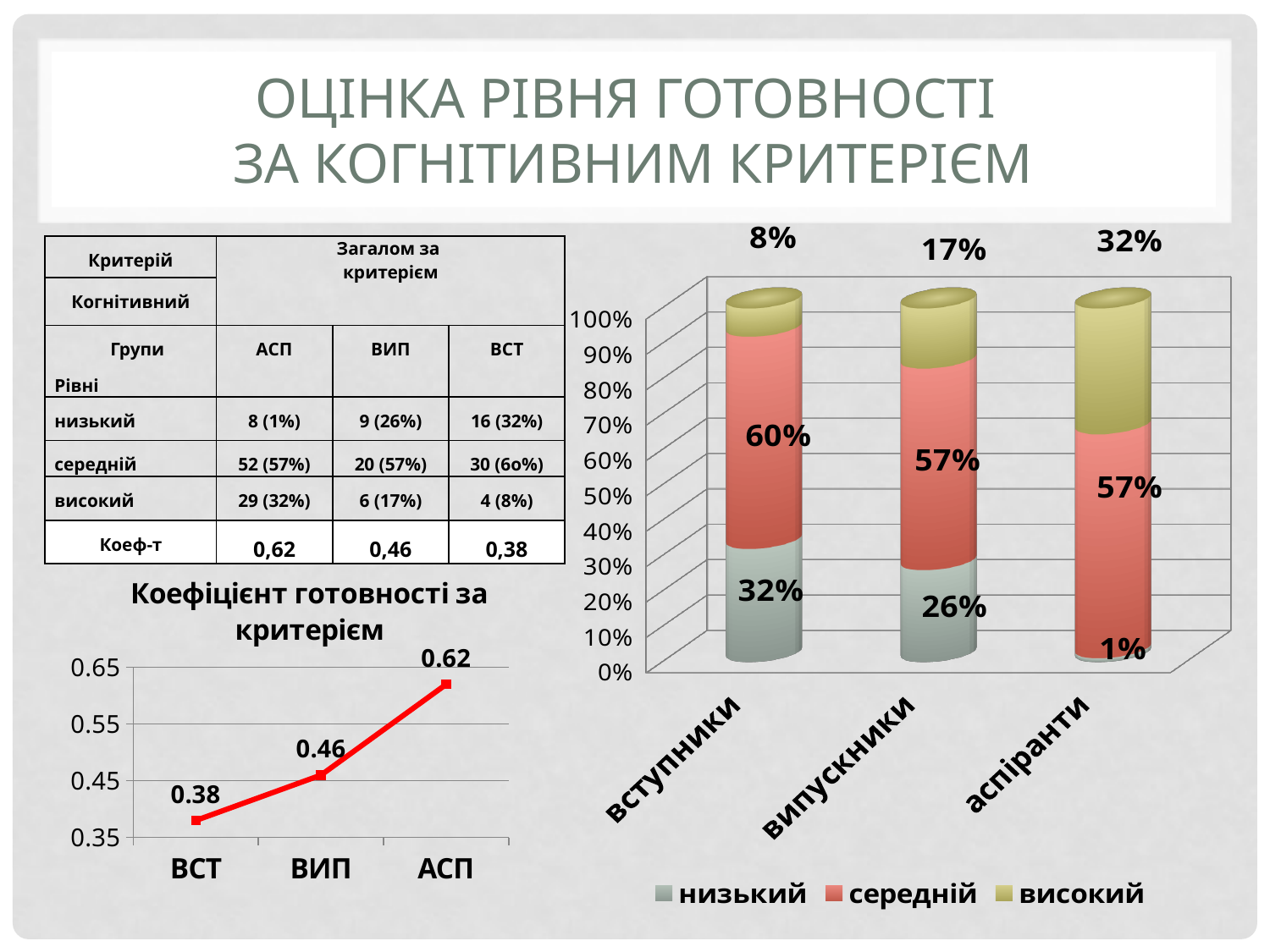
In the line chart titled 'Коефіцієнт готовності за критерієм', which category has the lowest value? ВСТ In the stacked bar chart on the right, what is the value of 'високий' for випускники? 17% In the line chart titled 'Коефіцієнт готовності за критерієм', what is the value for АСП? 0.62 In the stacked bar chart on the right, what is the value of 'середній' for вступники? 60% In the stacked bar chart on the right, which category has the highest 'високий' value? аспіранти In the stacked bar chart on the right, what is the value of 'низький' for аспіранти? 1% In the stacked bar chart on the right, how many series does the legend list? 3 In the line chart titled 'Коефіцієнт готовності за критерієм', what is the difference between the values for АСП and ВИП? 0.16 In the stacked bar chart on the right, is the 'низький' value larger for вступники or for випускники? вступники In the line chart titled 'Коефіцієнт готовності за критерієм', how many categories are on the x axis? 3 In the line chart titled 'Коефіцієнт готовності за критерієм', what is the value for ВСТ? 0.38 In the line chart titled 'Коефіцієнт готовності за критерієм', do the values rise or fall from ВСТ to АСП? rise